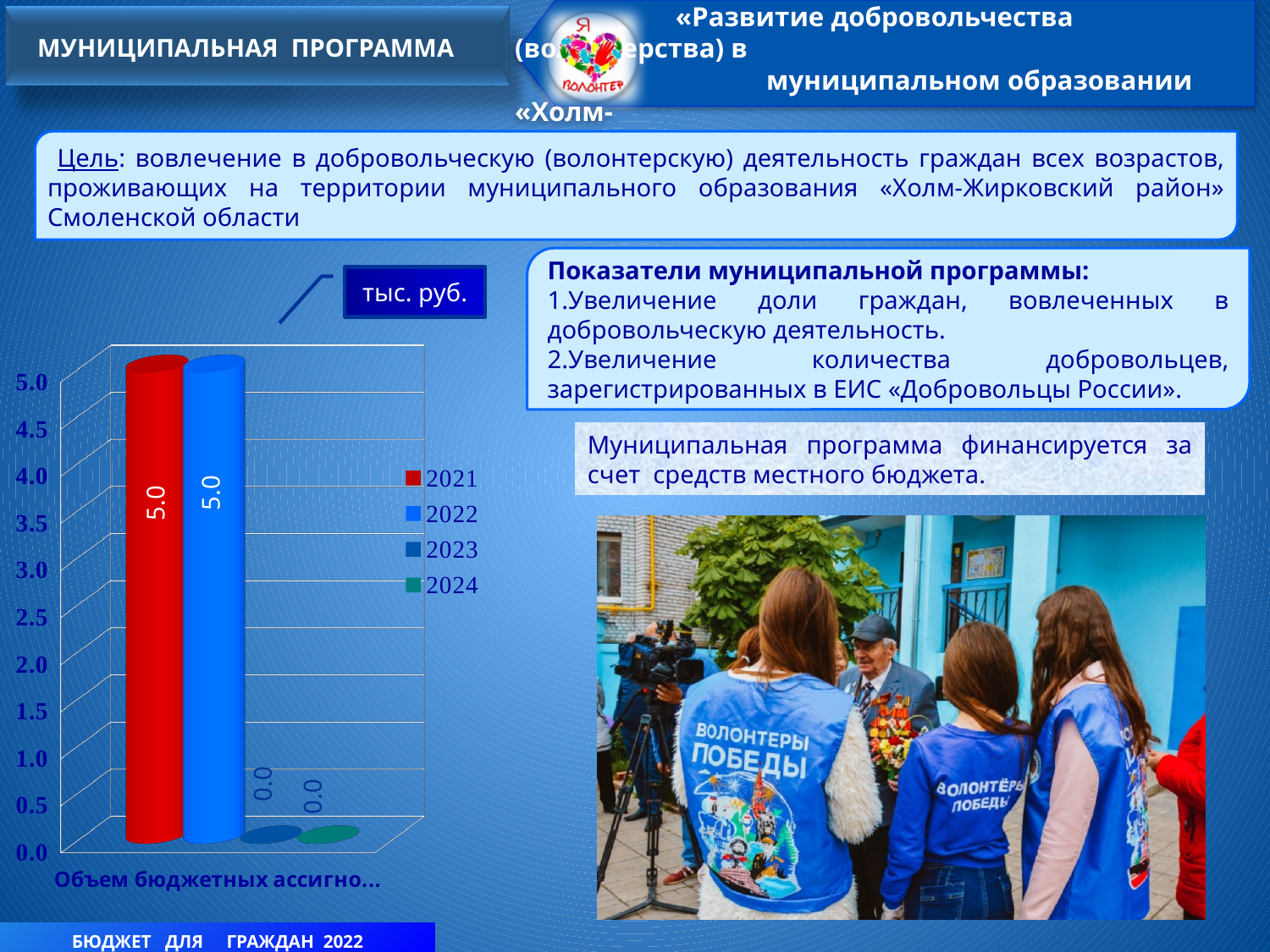
Which is larger, the value for 2021 or the value for 2023? 2021 Is the value for 2022 greater or less than 4.0? greater What is the value for 2024 in the chart? 0.0 What kind of chart is shown on the slide? Bar chart What is the value for 2022 in the chart? 5.0 How many series does the chart legend list? 4 Is the value for 2023 greater or less than 1.0? less What unit is shown in the box above the chart? тыс. руб. What colour is the bar for 2021 in the chart? Red What is the value for 2021 in the chart? 5.0 What is the value for 2023 in the chart? 0.0 What is the difference between the value for 2022 and the value for 2024? 5.0